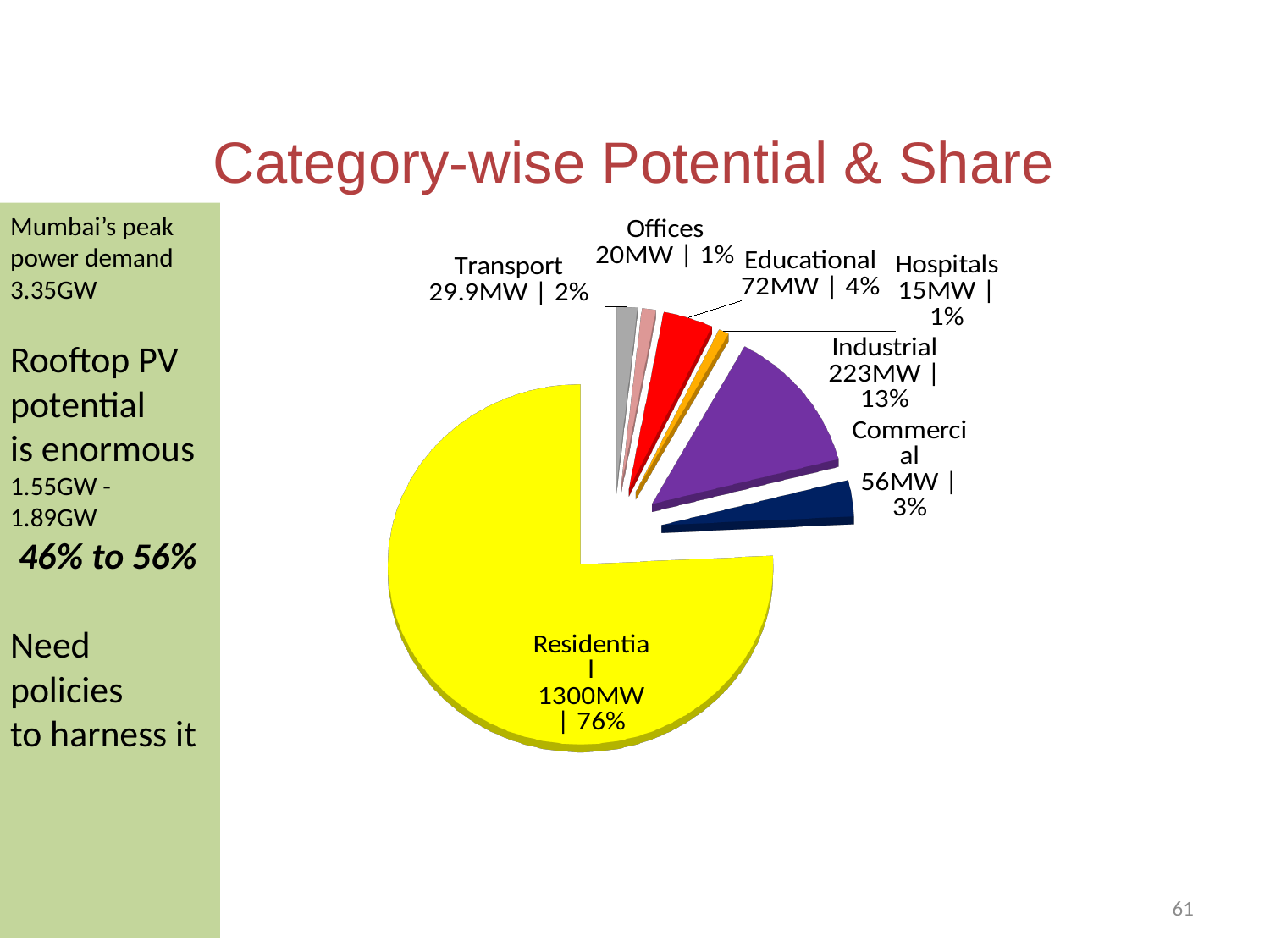
Which has a larger potential, Educational or Commercial? Educational How many categories does the pie chart show? 7 Which category has the largest potential? Residential Which category has the smallest potential? Hospitals What is the potential for the Transport category? 29.9MW What is the potential for the Industrial category? 223MW What kind of chart is shown on the slide? Pie chart What is the title of the chart on the slide? Category-wise Potential & Share What share of the pie does the Residential slice represent? 76% What is the difference in potential between Industrial and Commercial? 167MW What is the potential for the Hospitals category? 15MW What share of the pie does the Educational slice represent? 4%